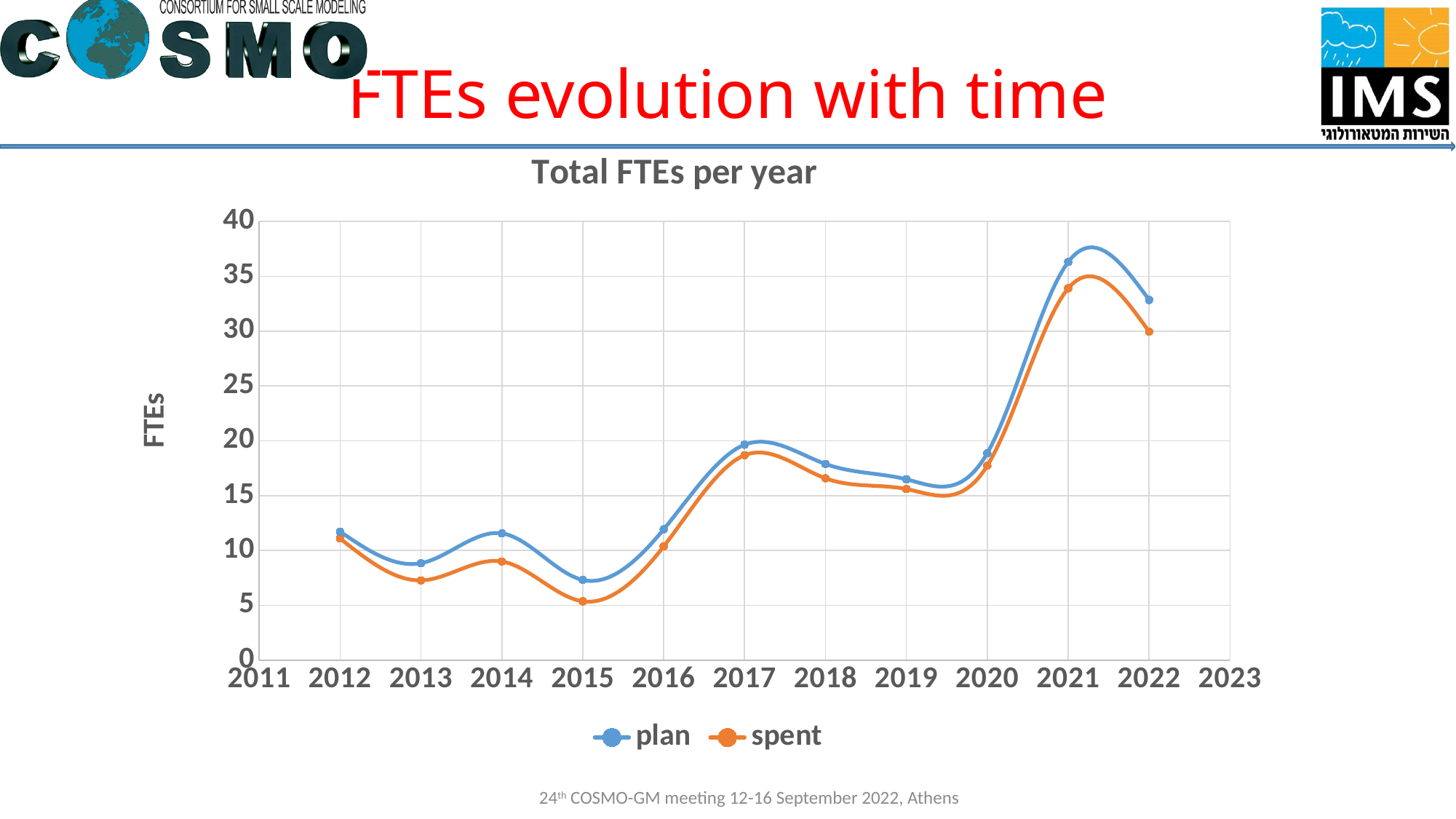
How many years have data points plotted for the plan series? 11 How many series does the legend list? 2 What colour is the line for the spent series? orange Is the value for spent in 2015 greater or less than 10? less What is the title of the chart? Total FTEs per year Is the value for plan in 2022 greater or less than 30? greater In which year is the spent series at its lowest? 2015 What kind of chart is shown on the slide? line chart Is the value for plan in 2021 greater or less than 35? greater Do the values of the spent series rise or fall from 2020 to 2021? rise In which year is the plan series at its highest? 2021 In 2015, which series has the larger value, plan or spent? plan